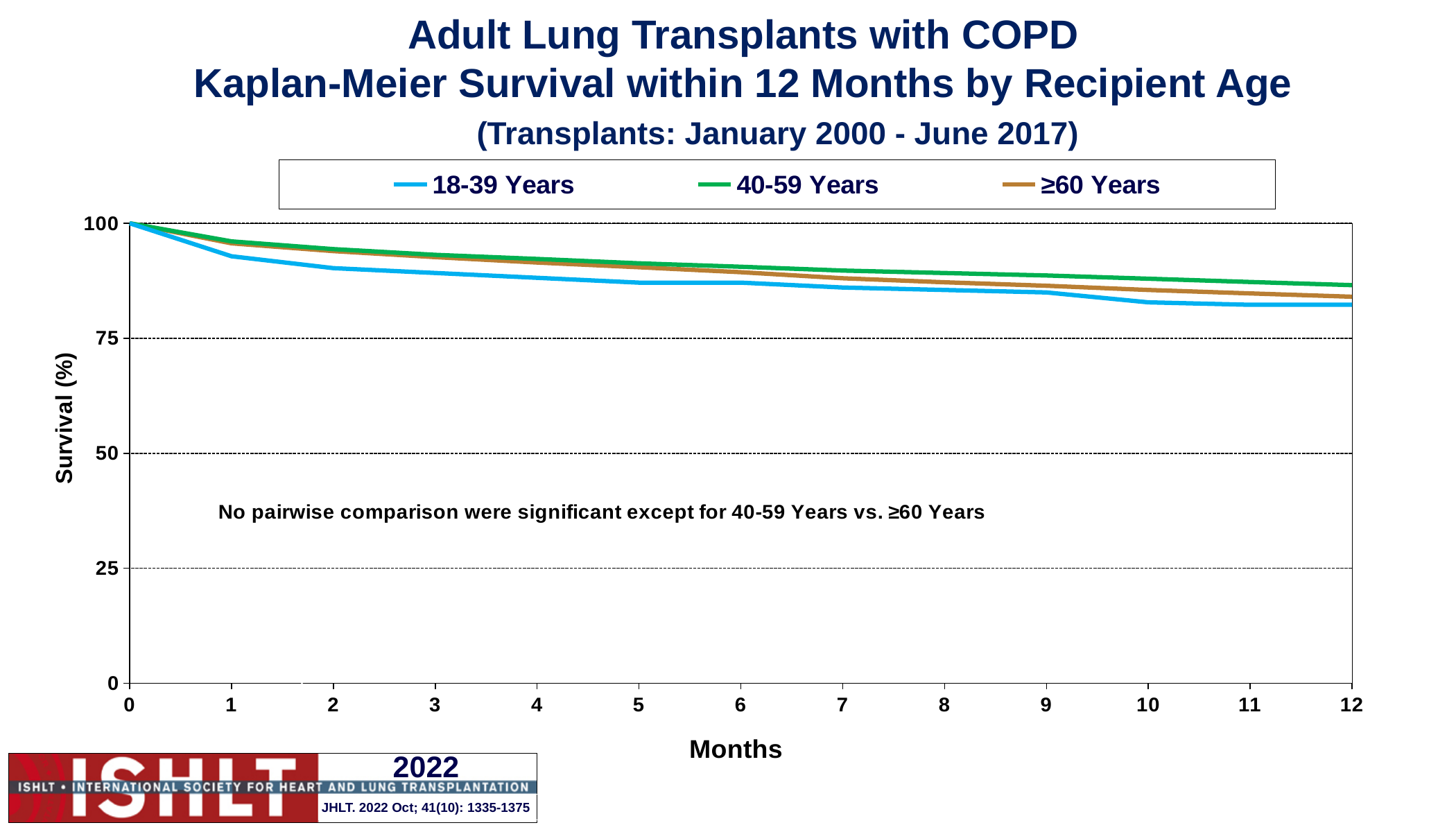
Which colour represents the ≥60 Years series? Brown Do the survival curves rise or fall as months increase? Fall What kind of chart is shown on the slide? Line chart How many series does the legend list? 3 Which age group has the highest survival at 12 months? 40-59 Years Which age group has the lowest survival at 12 months? 18-39 Years Is the survival value for ≥60 Years at 6 months greater or less than 75? greater How many month tick marks are labelled on the x axis? 13 What is the survival value for all three age groups at month 0? 100 At 12 months, is survival higher for 40-59 Years or 18-39 Years? 40-59 Years Is the survival value for 18-39 Years at 12 months greater or less than 75? greater What transplant date range is given in the chart subtitle? January 2000 - June 2017